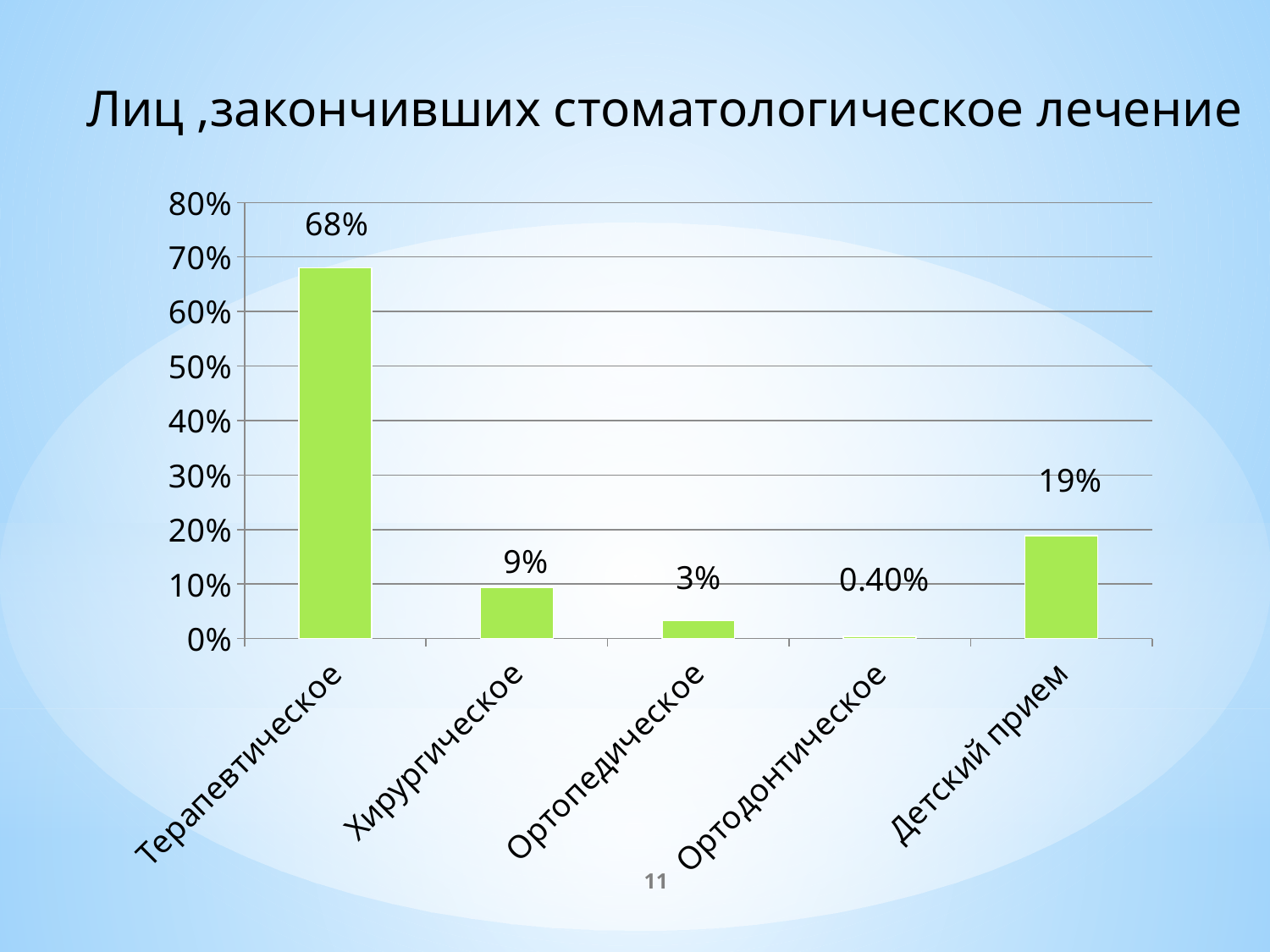
What is the difference between the values for Терапевтическое and Детский прием? 49% Is the value for Детский прием greater or less than 10%? greater What is the title of the slide? Лиц ,закончивших стоматологическое лечение What is the value for Терапевтическое? 68% What is the value for Хирургическое? 9% How many categories are shown on the x axis? 5 Which is larger, the value for Хирургическое or the value for Ортопедическое? Хирургическое What is the value for Ортодонтическое? 0.40% Which category has the highest value? Терапевтическое What is the value for Детский прием? 19% What kind of chart is shown on the slide? bar chart Which category has the lowest value? Ортодонтическое